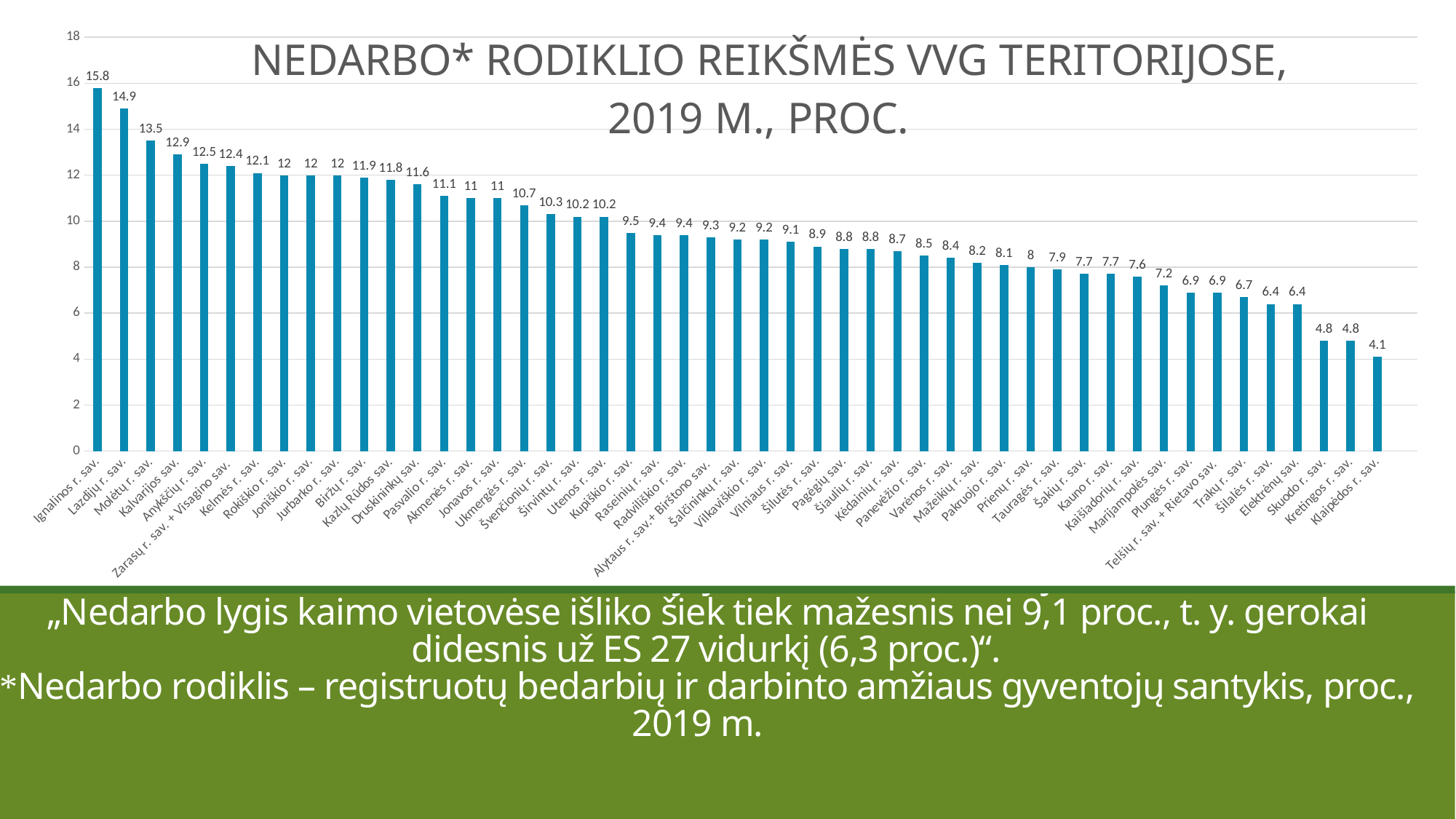
Which category has the highest value? Ignalinos r. sav. Do the values rise or fall from left to right along the x axis? fall What is the difference between the values for Ignalinos r. sav. and Lazdijų r. sav.? 0.9 Which is larger, the value for Molėtų r. sav. or the value for Kalvarijos sav.? Molėtų r. sav. Which category has the lowest value? Klaipėdos r. sav. What is the value for Klaipėdos r. sav.? 4.1 What is the value for Ignalinos r. sav.? 15.8 What is the value for Marijampolės sav.? 7.2 What kind of chart is shown on the slide? bar chart What is the value for Ukmergės r. sav.? 10.7 Is the value for Trakų r. sav. greater or less than 8? less What is the title of the chart? NEDARBO* RODIKLIO REIKŠMĖS VVG TERITORIJOSE, 2019 M., PROC.